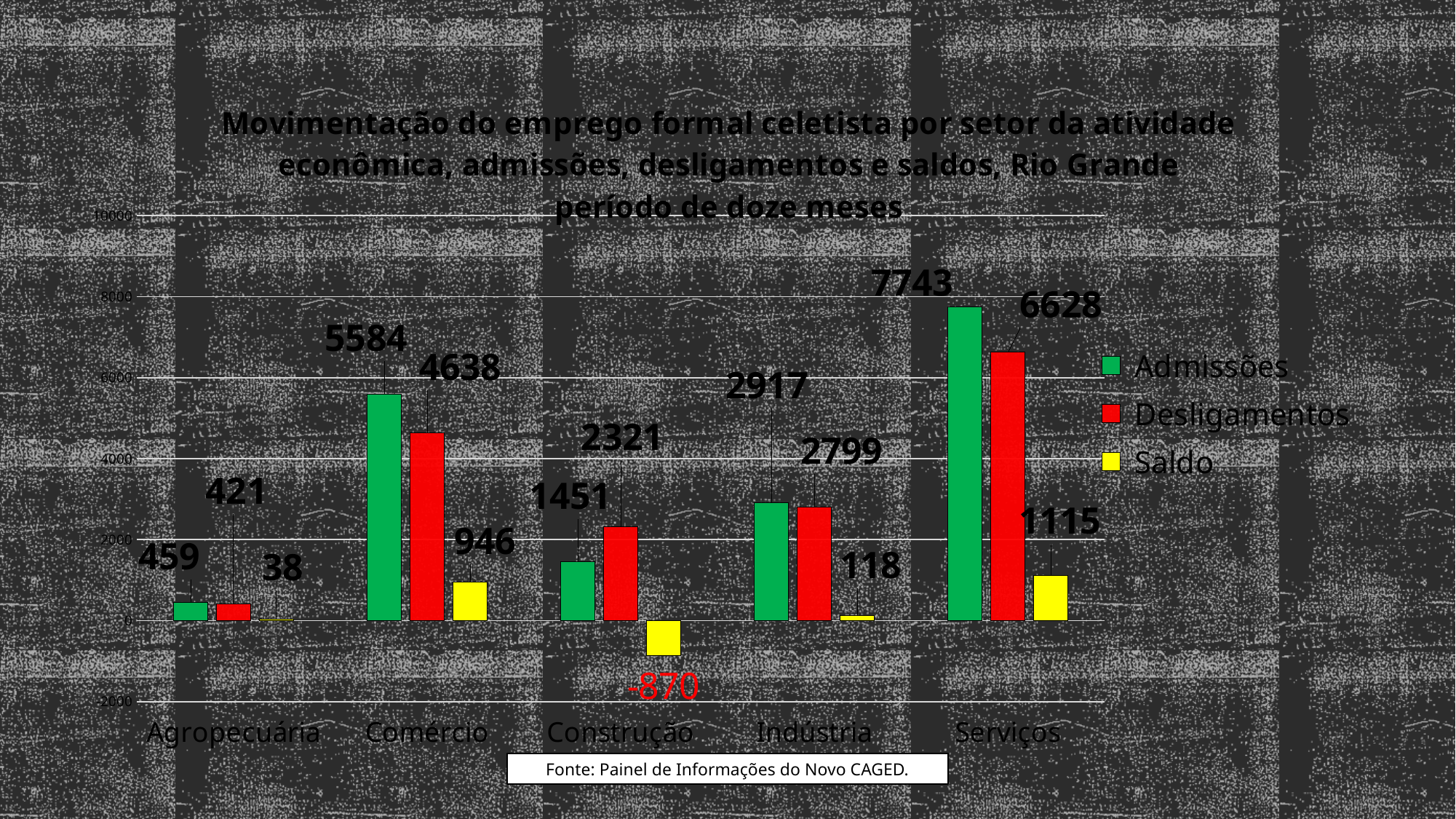
Which colour represents the Saldo series in the legend? Yellow What is the Admissões value for Comércio? 5584 How many sectors are shown on the x axis? 5 Which sector has the highest Admissões value? Serviços What is the Desligamentos value for Serviços? 6628 How many series does the legend list? 3 What kind of chart is shown on the slide? Bar chart Is the Admissões value for Serviços greater or less than 6000? greater What is the Saldo value for Construção? -870 For Construção, which is larger: Admissões or Desligamentos? Desligamentos What is the difference between Admissões and Desligamentos for Indústria? 118 Which sector has the lowest Saldo value? Construção